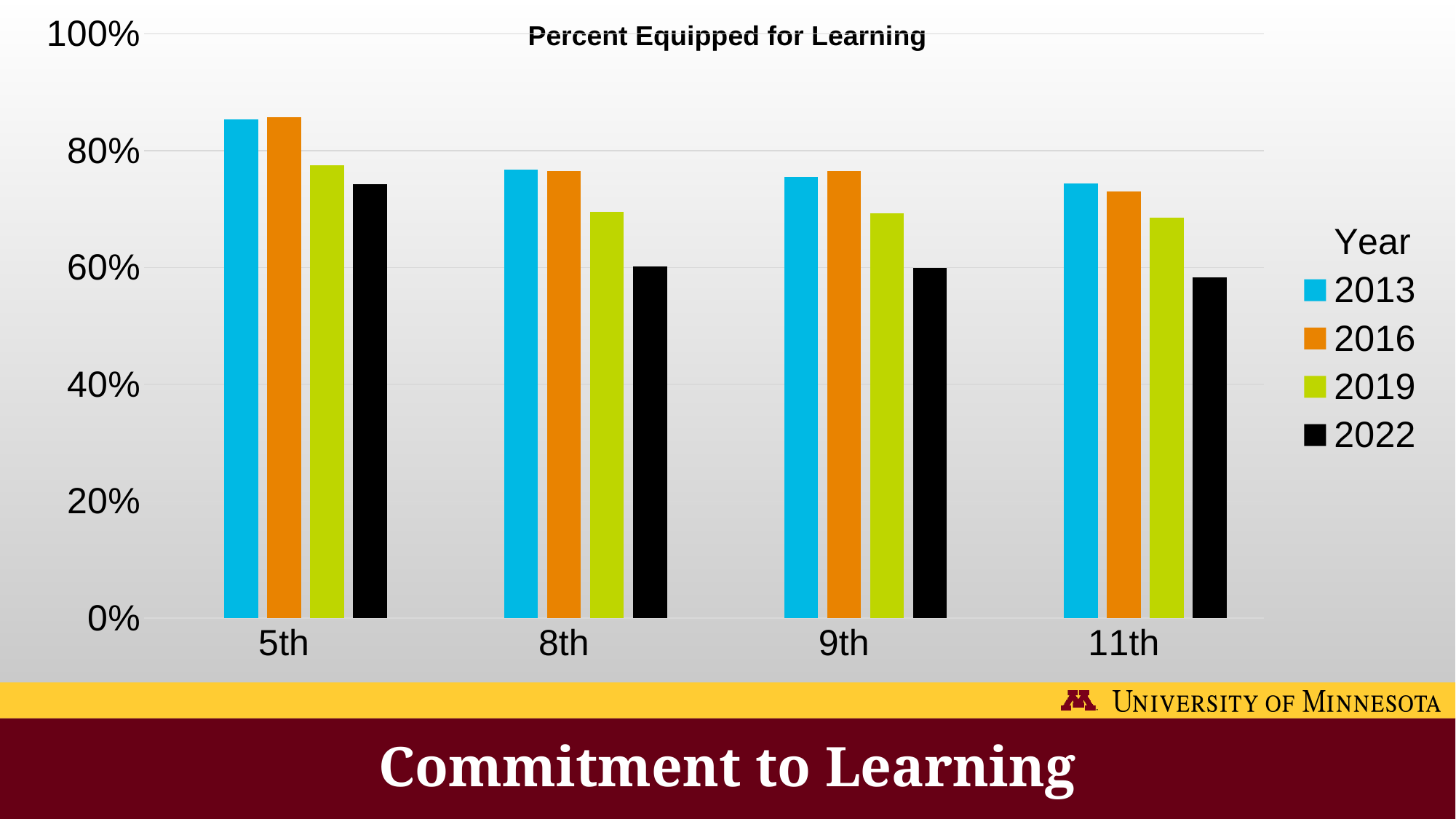
For the 2022 series, which grade has the highest value? 5th Which colour represents 2022 in the legend? black How many years does the legend list? 4 Is the value for 2022 in 5th grade greater or less than 60%? greater Is the value for 2019 in 11th grade greater or less than 80%? less How many grade categories are shown on the x axis? 4 In 8th grade, which is larger: the value for 2019 or the value for 2022? 2019 What kind of chart is shown on the slide? bar chart Is the value for 2013 in 5th grade greater or less than 80%? greater What is the title of the chart? Percent Equipped for Learning In 5th grade, which is larger: the value for 2013 or the value for 2022? 2013